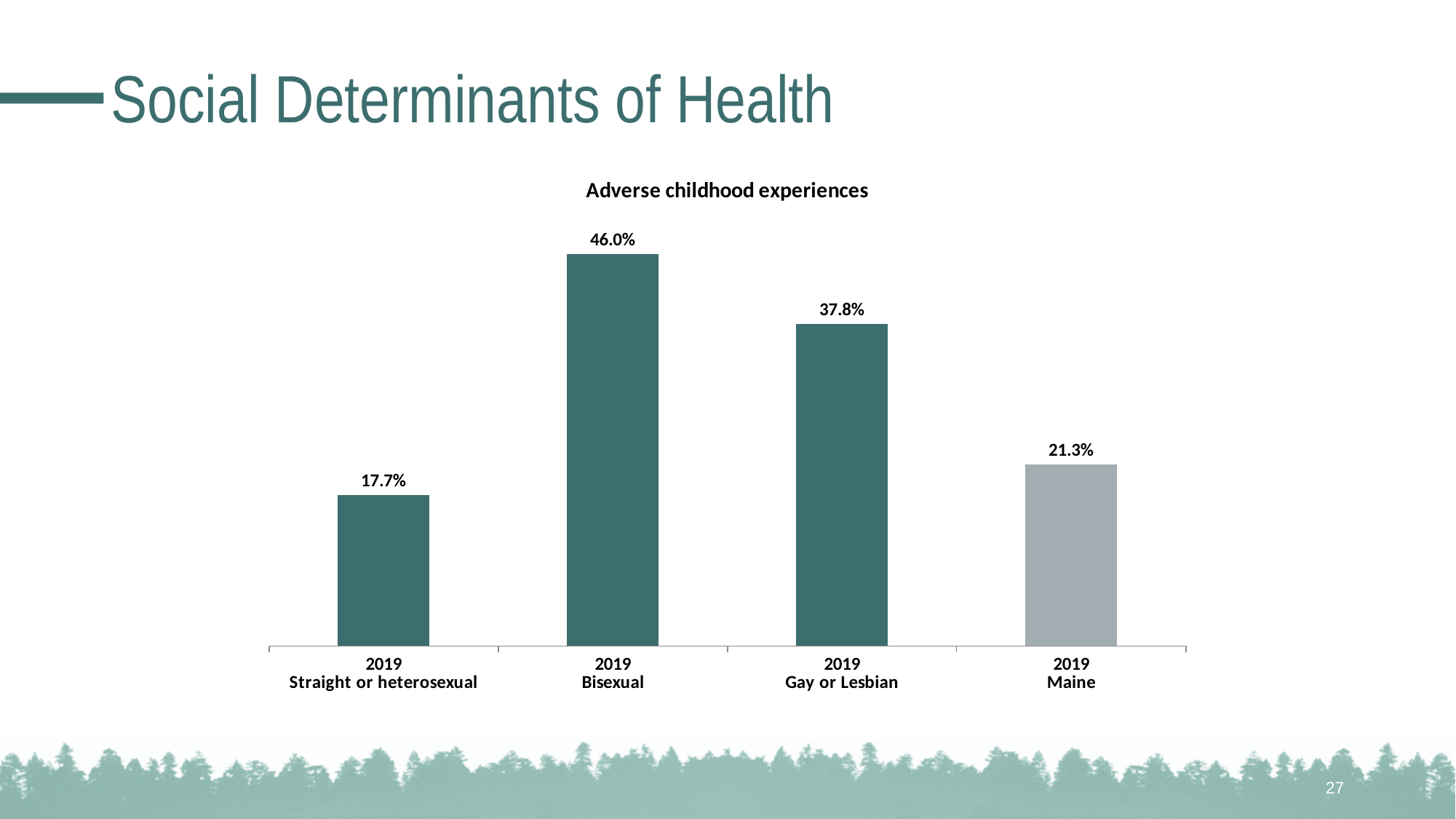
What is the value for Gay or Lesbian in the Adverse childhood experiences chart? 37.8% What is the difference between the Bisexual and Gay or Lesbian values in the Adverse childhood experiences chart? 8.2% Which category has the highest value in the Adverse childhood experiences chart? Bisexual What is the difference between the Maine and Straight or heterosexual values in the Adverse childhood experiences chart? 3.6% What is the title of the chart on the slide? Adverse childhood experiences What kind of chart is shown on the slide? Bar chart Which is larger in the Adverse childhood experiences chart, the value for Gay or Lesbian or the value for Maine? Gay or Lesbian What is the value for Maine in the Adverse childhood experiences chart? 21.3% What is the value for Straight or heterosexual in the Adverse childhood experiences chart? 17.7% Which category has the lowest value in the Adverse childhood experiences chart? Straight or heterosexual How many bars are shown in the Adverse childhood experiences chart? 4 What is the value for Bisexual in the Adverse childhood experiences chart? 46.0%